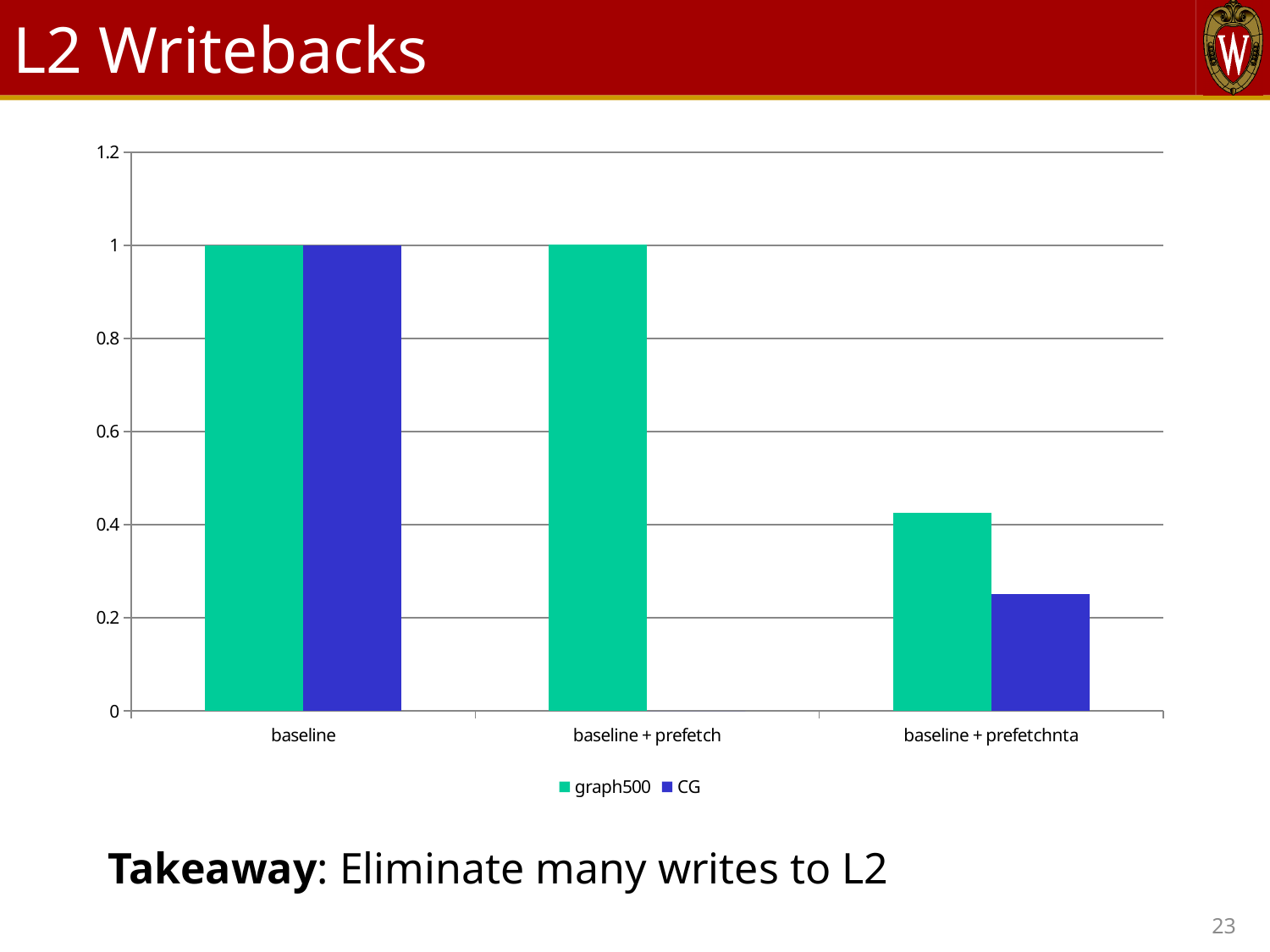
What is the value for CG in the baseline category? 1 How many categories are shown on the x axis? 3 What is the value for graph500 in the baseline category? 1 Is the value for graph500 in the baseline + prefetchnta category greater or less than 0.6? less In the baseline + prefetchnta category, which series has the larger value, graph500 or CG? graph500 What kind of chart is shown on the slide? bar chart Which colour represents the CG series in the legend? blue For the graph500 series, which category has the lowest value? baseline + prefetchnta How many series does the legend list? 2 What is the value for graph500 in the baseline + prefetch category? 1 Is the value for CG in the baseline + prefetchnta category greater or less than 0.4? less What is the title of the chart? L2 Writebacks